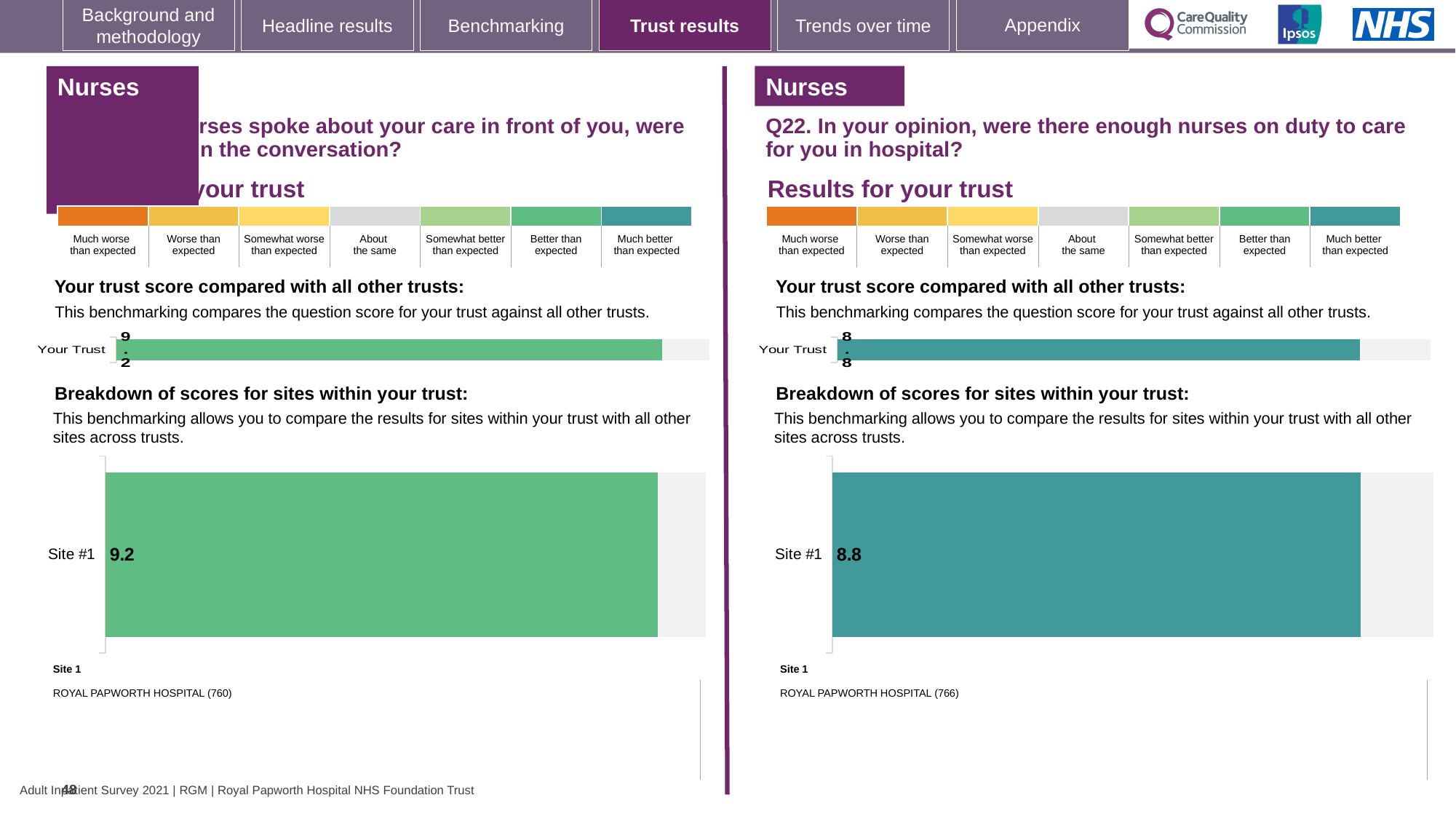
On the left panel, which site name is listed as Site 1 below the breakdown chart? ROYAL PAPWORTH HOSPITAL (760) What is the difference between the Site #1 score on the left panel and the Site #1 score on the right panel (Q22)? 0.4 On the right panel (Q22), what is the value shown for 'Your Trust' in the trust score comparison chart? 8.8 On the left panel, what is the score shown for Site #1 in the breakdown of scores for sites within your trust? 9.2 How many sites are shown in the breakdown of scores chart on the left panel? 1 On the right panel (Q22), what is the score shown for Site #1 in the breakdown of scores for sites within your trust? 8.8 How many sites are shown in the breakdown of scores chart on the right panel (Q22)? 1 What kind of chart is used to show the Site #1 score on the right panel (Q22)? Bar chart Which Site #1 score is larger: the one on the left panel or the one on the right panel (Q22)? Left panel (9.2) On the right panel (Q22), which site name is listed as Site 1 below the breakdown chart? ROYAL PAPWORTH HOSPITAL (766) On the left panel, what is the value shown for 'Your Trust' in the trust score comparison chart? 9.2 Is the Site #1 score on the right panel (Q22) greater or less than the Site #1 score on the left panel? less